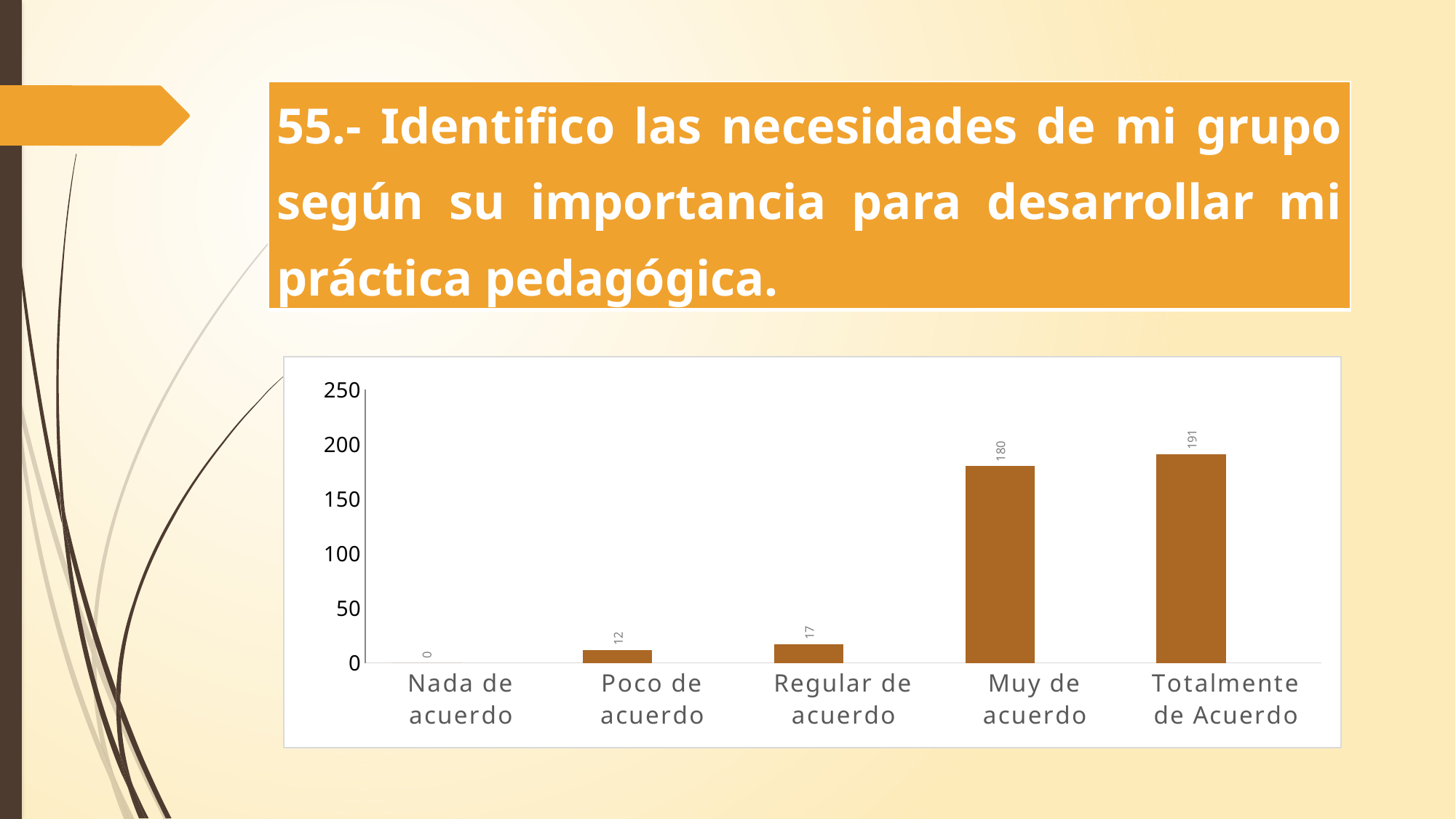
What is the difference between the values for "Totalmente de Acuerdo" and "Muy de acuerdo"? 11 Is the value for "Muy de acuerdo" greater or less than 150? greater Which is larger, the value for "Regular de acuerdo" or the value for "Poco de acuerdo"? Regular de acuerdo What is the value for "Regular de acuerdo"? 17 What kind of chart is shown on the slide? bar chart What is the value for "Muy de acuerdo"? 180 What is the value for "Poco de acuerdo"? 12 Which category has the highest value? Totalmente de Acuerdo How many categories are shown on the x axis of the chart? 5 What is the value for "Totalmente de Acuerdo"? 191 What is the value for "Nada de acuerdo"? 0 Which category has the lowest value? Nada de acuerdo